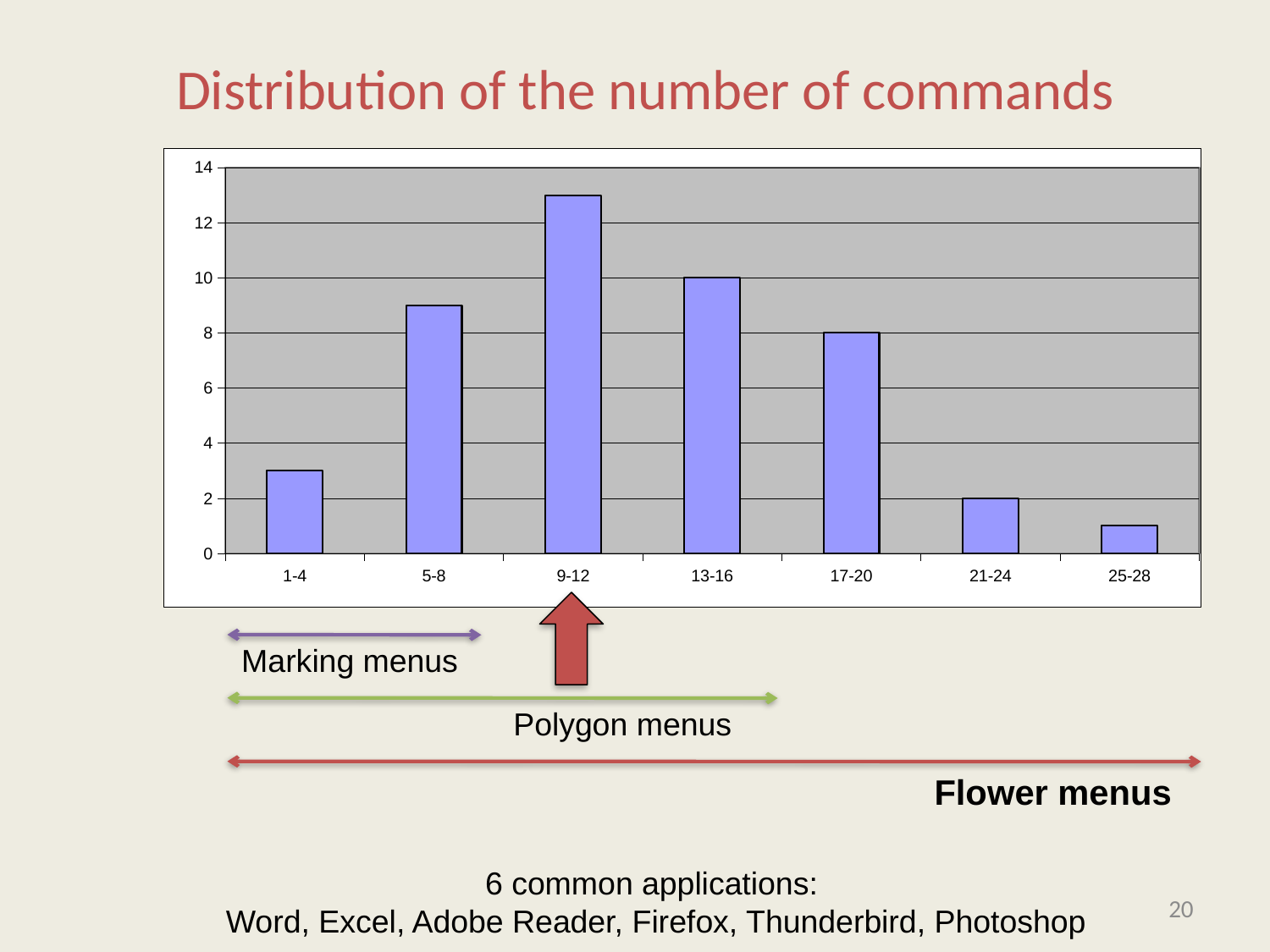
What is the difference between the values for 13-16 and 17-20? 2 Which category has the larger value, 1-4 or 5-8? 5-8 What is the value for the 21-24 category? 2 What is the value for the 13-16 category? 10 Which category has the highest bar? 9-12 What is the title of the chart? Distribution of the number of commands Is the value for 9-12 greater or less than 12? greater How many categories are shown on the x axis of the chart? 7 What kind of chart is shown on the slide? Bar chart Is the value for 1-4 greater or less than 4? less What is the value for the 17-20 category? 8 Which category has the lowest bar? 25-28